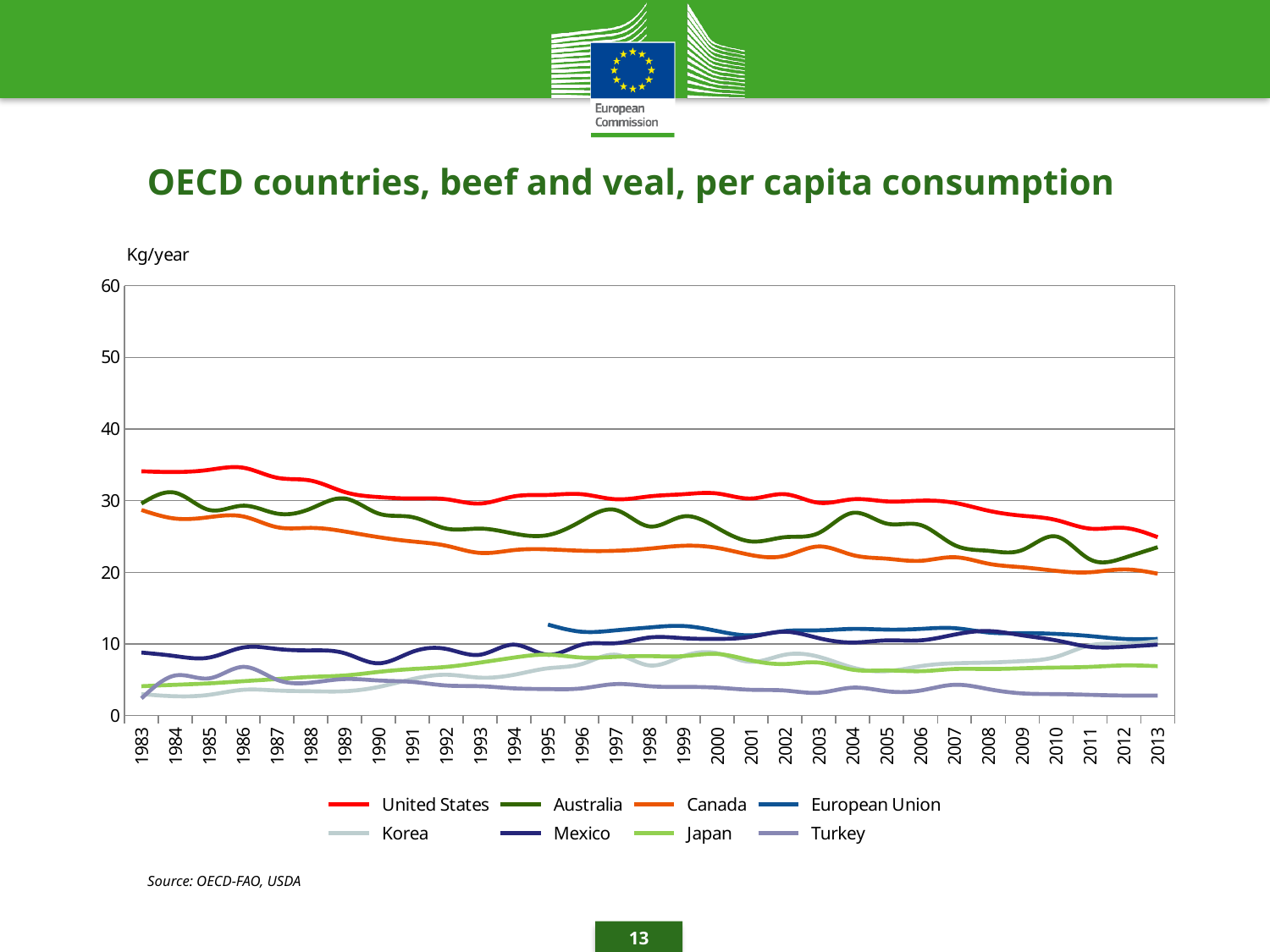
Is the value for Turkey in 2013 greater or less than 10? less How many series does the legend list? 8 In 1983, which is higher: the United States or Australia? United States What unit is shown on the y axis? Kg/year Is the value for the United States in 1983 greater or less than 30? greater Does the United States line rise or fall from 1983 to 2013? fall What kind of chart is shown on the slide? line chart Does the Canada line rise or fall from 1983 to 2013? fall Which country has the highest per capita consumption in 2013? United States How many years are shown along the x axis? 31 Is the value for the European Union in 2000 greater or less than 10? greater Which country has the lowest per capita consumption in 2013? Turkey